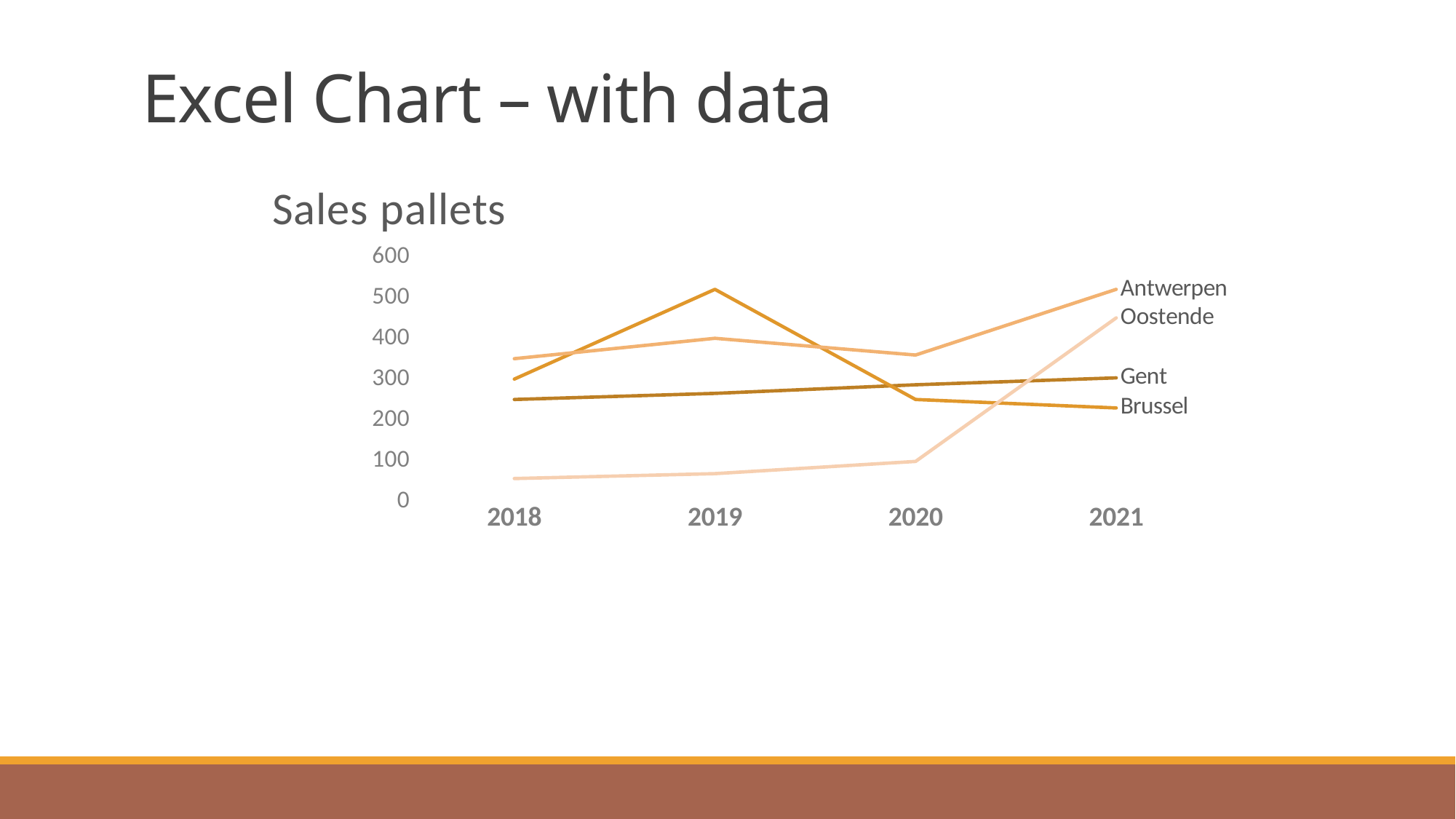
Does the Brussel series rise or fall from 2019 to 2021? fall Which series has the highest value in 2019? Brussel Which is larger in 2020, the value for Antwerpen or the value for Gent? Antwerpen What is the title of the chart? Sales pallets Is the value for Brussel in 2019 greater or less than 500? greater Is the value for Oostende in 2020 greater or less than 200? less Does the Gent series rise or fall from 2018 to 2021? rise Which series has the lowest value in 2018? Oostende Which series has the highest value in 2021? Antwerpen What kind of chart is shown on the slide? line chart How many years are shown on the x axis of the chart? 4 How many series are plotted in the chart? 4